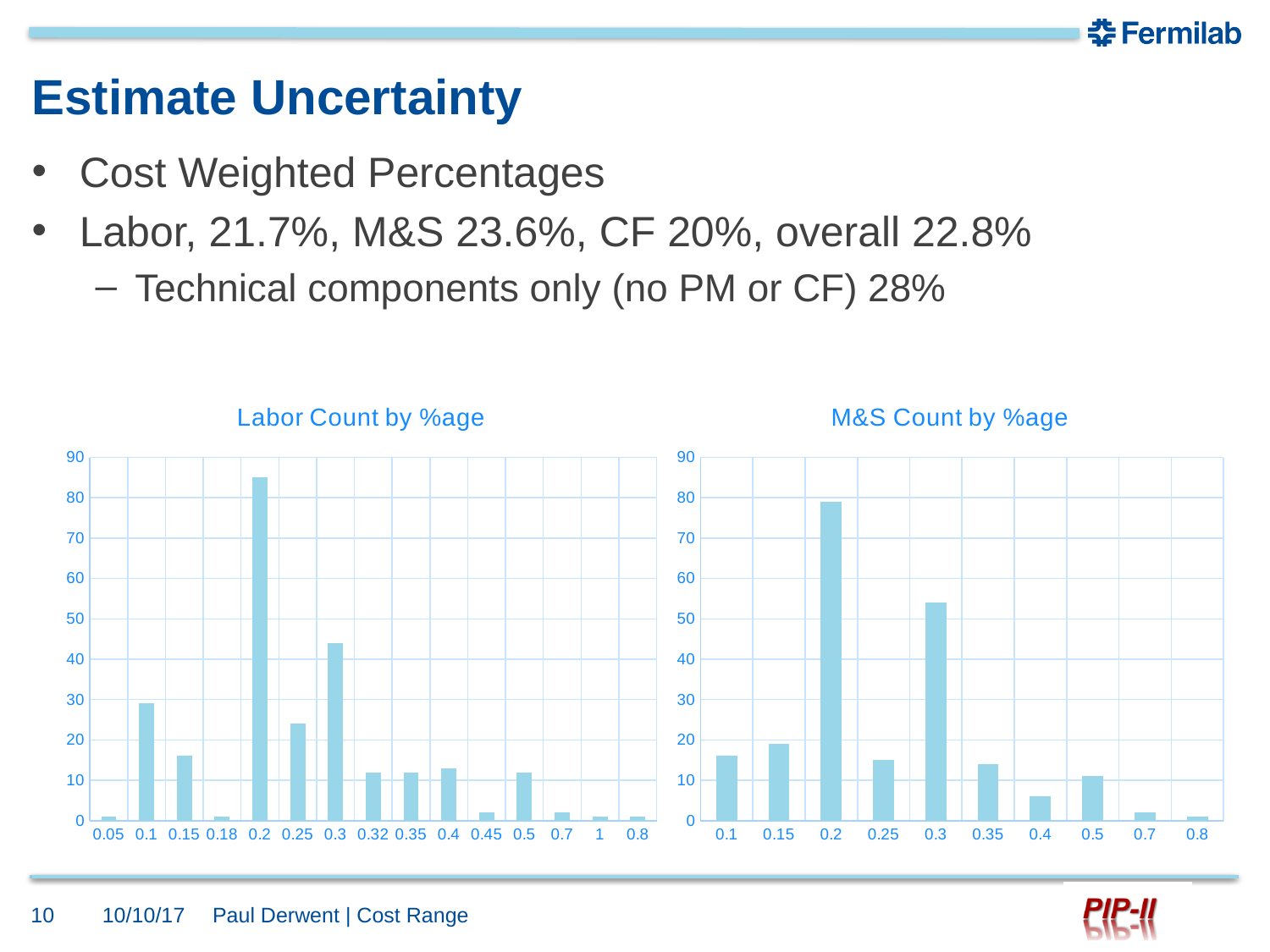
How many categories are shown on the x axis of the "Labor Count by %age" chart? 15 In the "Labor Count by %age" chart, which is larger, the value for 0.25 or the value for 0.3? 0.3 In the "Labor Count by %age" chart, which category has the highest count? 0.2 In the "M&S Count by %age" chart, which is larger, the value for 0.3 or the value for 0.35? 0.3 How many categories are shown on the x axis of the "M&S Count by %age" chart? 10 What is the title of the chart on the right side of the slide? M&S Count by %age In the "M&S Count by %age" chart, is the value for 0.4 greater or less than 10? less In the "Labor Count by %age" chart, is the value for 0.3 greater or less than 40? greater In the "M&S Count by %age" chart, is the value for 0.3 greater or less than 50? greater What kind of chart is the "Labor Count by %age" chart? bar chart In the "M&S Count by %age" chart, which category has the highest count? 0.2